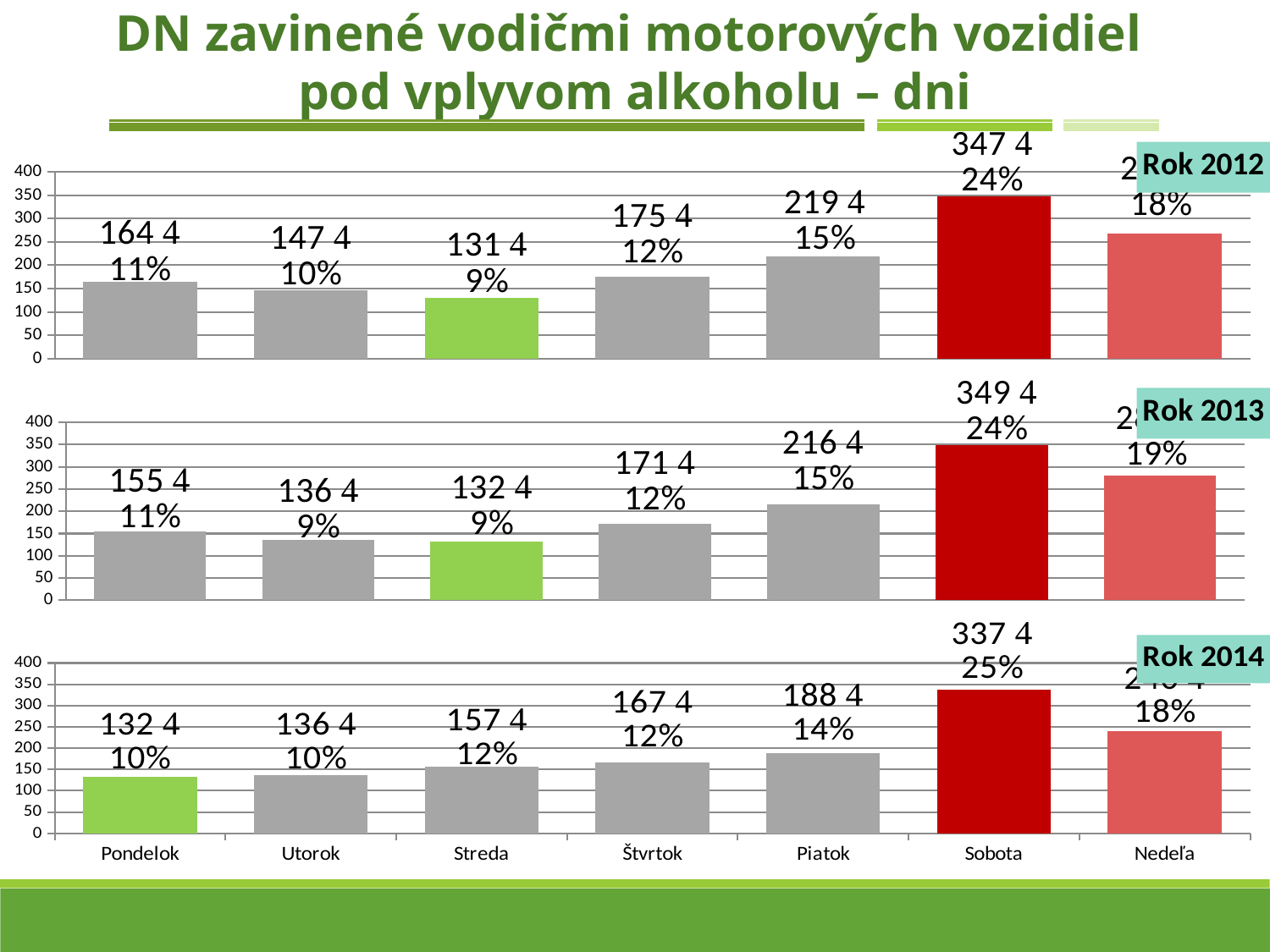
In the Rok 2014 chart, what percentage is shown for Piatok? 14% In the Rok 2012 chart, which day has the highest value? Sobota In the Rok 2014 chart, is the value for Utorok greater or less than 150? less In the Rok 2012 chart, is the value for Sobota greater or less than 300? greater In the Rok 2014 chart, which day has the lowest value? Pondelok In the Rok 2013 chart, which is larger, the value for Piatok or the value for Štvrtok? Piatok How many days (categories) are shown on the x axis of the charts? 7 In the Rok 2013 chart, what percentage is shown for Nedeľa? 19% In the Rok 2012 chart, what is the difference in percentage points between Sobota (24%) and Streda (9%)? 15 percentage points In the Rok 2012 chart, what percentage is shown for Sobota? 24% What kind of chart is used for Rok 2013? bar chart In the Rok 2012 chart, which day has the lowest value? Streda